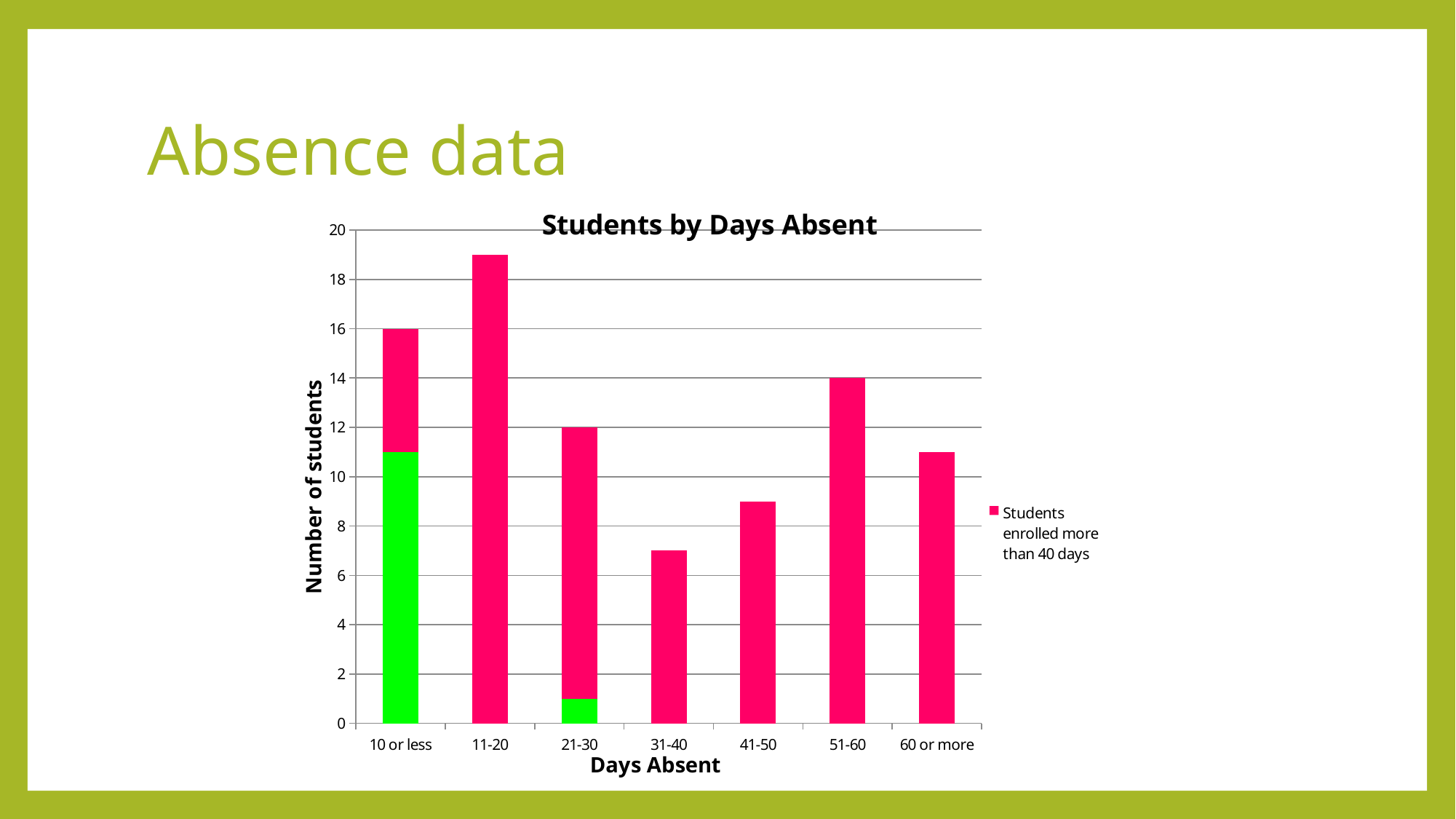
Is the value for '11-20' days absent greater or less than 18? greater What is the total height of the bar for '10 or less' days absent? 16 How many days-absent categories are shown on the x axis? 7 What is the difference between the total bar for '10 or less' and the total bar for '21-30'? 4 What is the number of students for the '51-60' days absent category? 14 Is the value for '31-40' days absent greater or less than 8? less Which days-absent category has the lowest number of students? 31-40 Which days-absent category has the highest number of students? 11-20 How many series does the legend list? 1 What type of chart is shown on the slide? bar chart What is the title of the chart? Students by Days Absent Which is larger, the bar for '51-60' or the bar for '60 or more'? 51-60